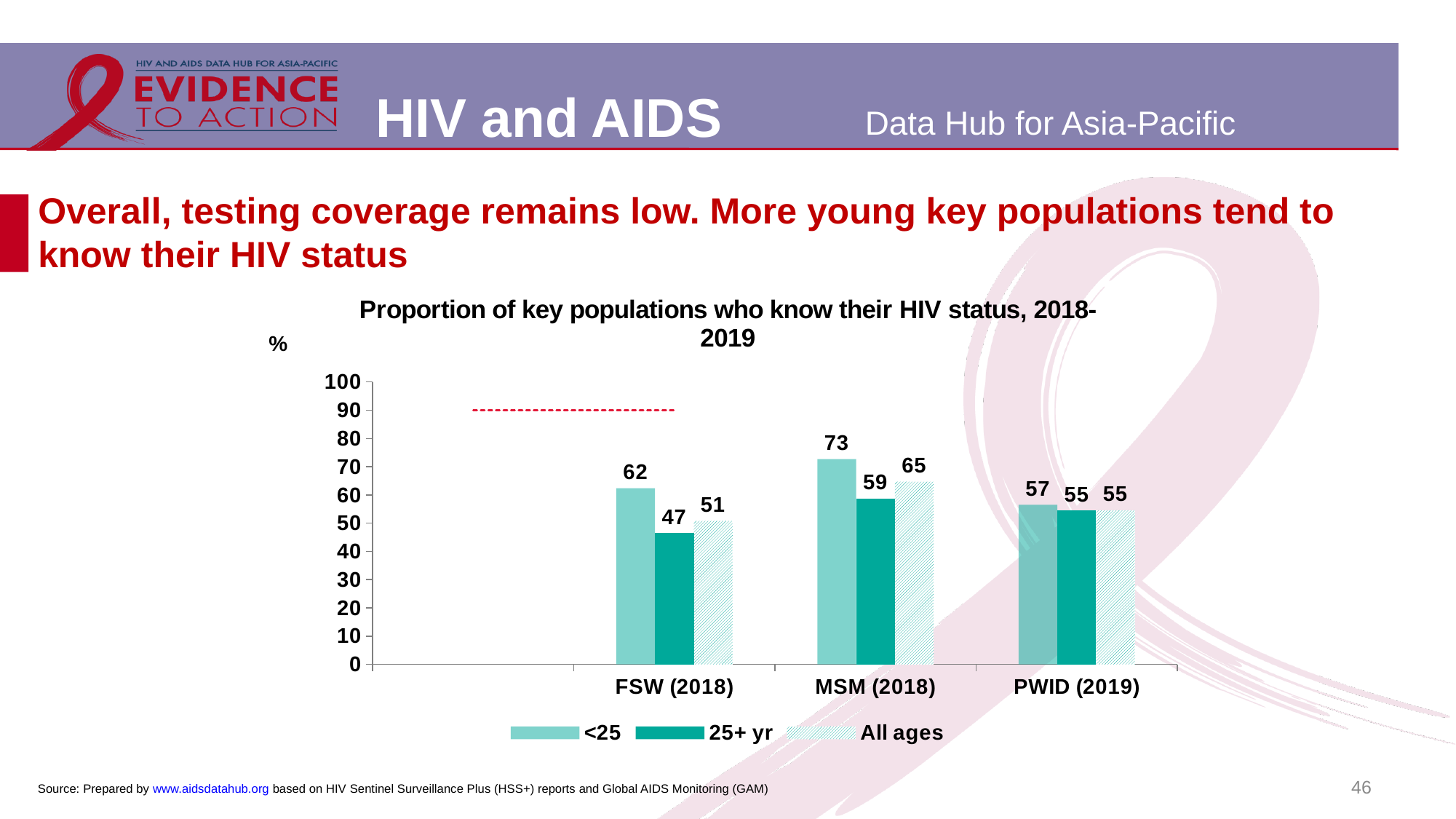
What is the value for All ages in the PWID (2019) group? 55 Which group has the lowest value for the 25+ yr series? FSW (2018) How many key population groups are shown on the x axis? 3 Which is larger for MSM (2018): the <25 value or the All ages value? <25 How many series does the legend list? 3 Which group has the highest value for the <25 series? MSM (2018) What is the difference between the <25 and 25+ yr values for FSW (2018)? 15 What is the value for <25 in the FSW (2018) group? 62 What is the value for 25+ yr in the MSM (2018) group? 59 Is the value for All ages in the FSW (2018) group greater or less than 60? less What kind of chart is shown on the slide? bar chart What is the title of the chart? Proportion of key populations who know their HIV status, 2018-2019